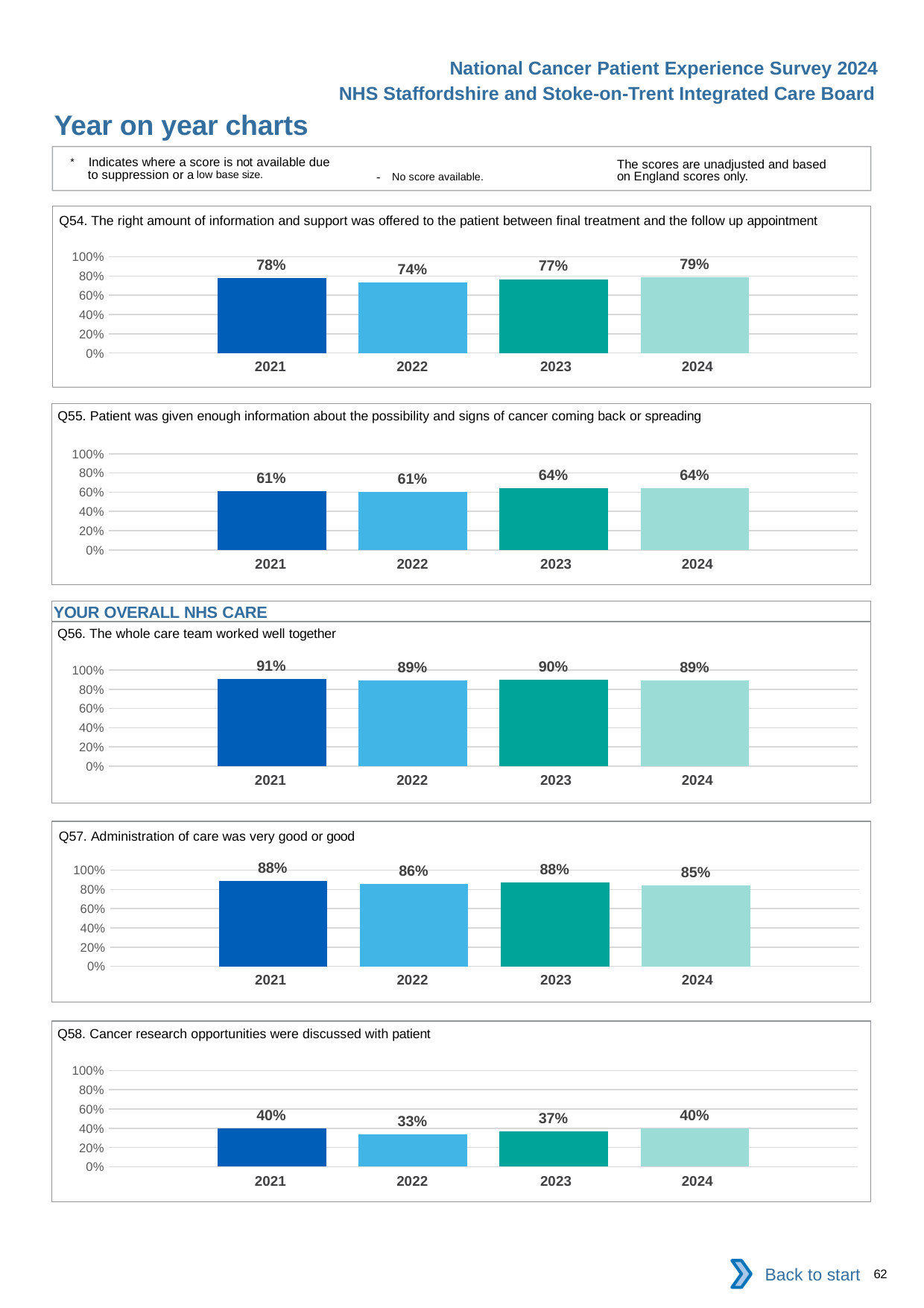
In the Q57 chart, which year has the lowest value? 2024 In the Q55 chart, what is the value for 2023? 64% In the Q56 chart, which year has the highest value? 2021 In the Q54 chart, which year has the highest value? 2024 In the Q58 chart, what is the value for 2022? 33% In the Q57 chart, is the value for 2022 larger or smaller than the value for 2023? smaller What type of chart is used for Q54? Bar chart How many years are shown in the Q58 chart? 4 In the Q56 chart, what is the value for 2024? 89% In the Q58 chart, what is the difference between the 2021 value and the 2022 value? 7 percentage points In the Q54 chart, what is the value for 2022? 74% In the Q55 chart, what is the difference between the 2024 value and the 2021 value? 3 percentage points